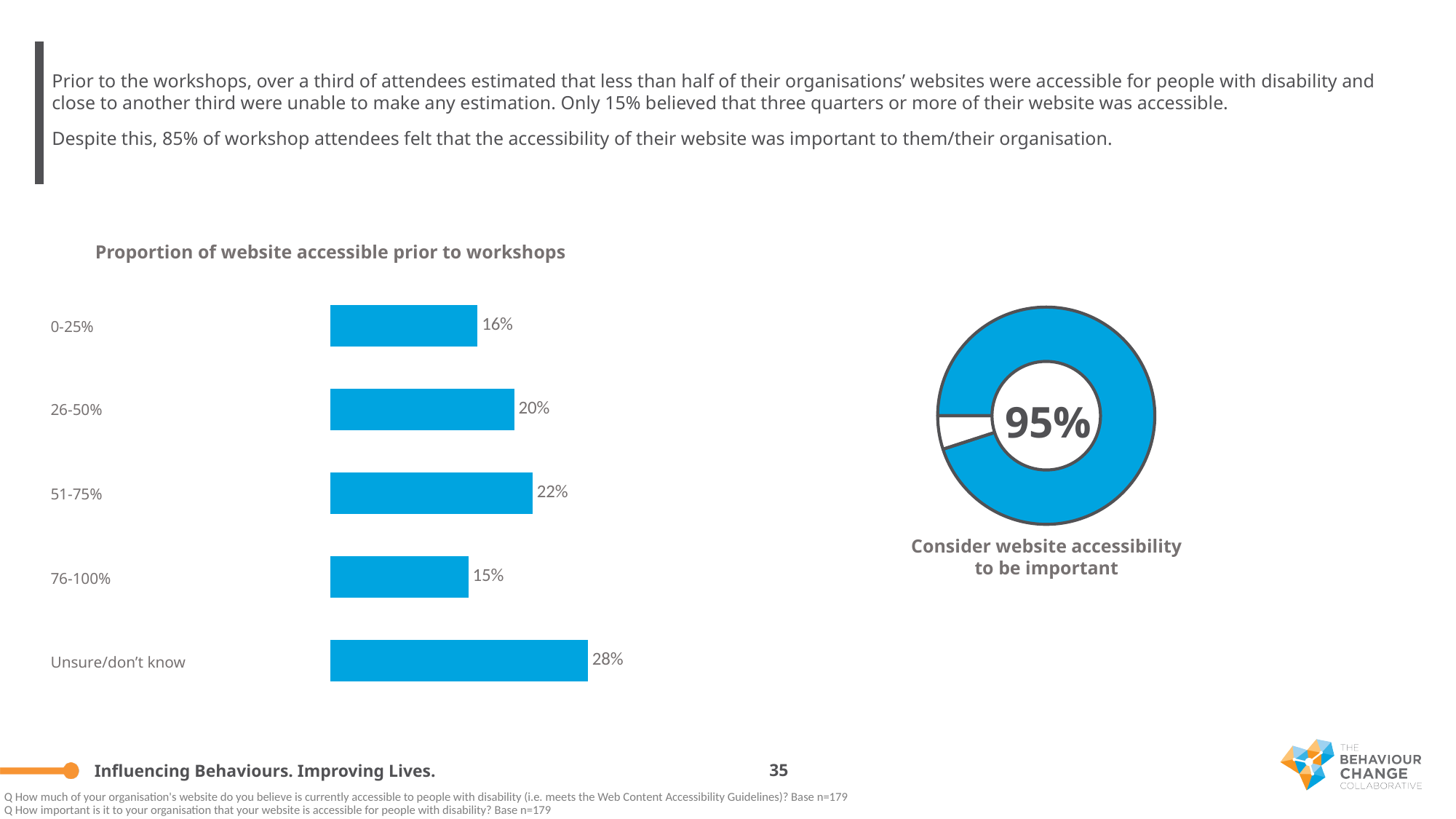
What is the title of the bar chart on the left of the slide? Proportion of website accessible prior to workshops In the 'Proportion of website accessible prior to workshops' chart, which is larger: the value for 51-75% or the value for 0-25%? 51-75% In the 'Proportion of website accessible prior to workshops' chart, what is the value for Unsure/don't know? 28% In the 'Proportion of website accessible prior to workshops' chart, what is the value for 26-50%? 20% In the 'Proportion of website accessible prior to workshops' chart, which category has the highest value? Unsure/don't know In the 'Proportion of website accessible prior to workshops' chart, what is the value for 0-25%? 16% What kind of chart is the 'Proportion of website accessible prior to workshops' chart? Bar chart What kind of chart is the chart on the right of the slide labelled 'Consider website accessibility to be important'? Donut chart In the 'Proportion of website accessible prior to workshops' chart, which category has the lowest value? 76-100% What percentage is shown in the centre of the donut chart on the right of the slide? 95% In the 'Proportion of website accessible prior to workshops' chart, what is the difference between the values for Unsure/don't know and 76-100%? 13% How many categories are shown in the 'Proportion of website accessible prior to workshops' chart? 5